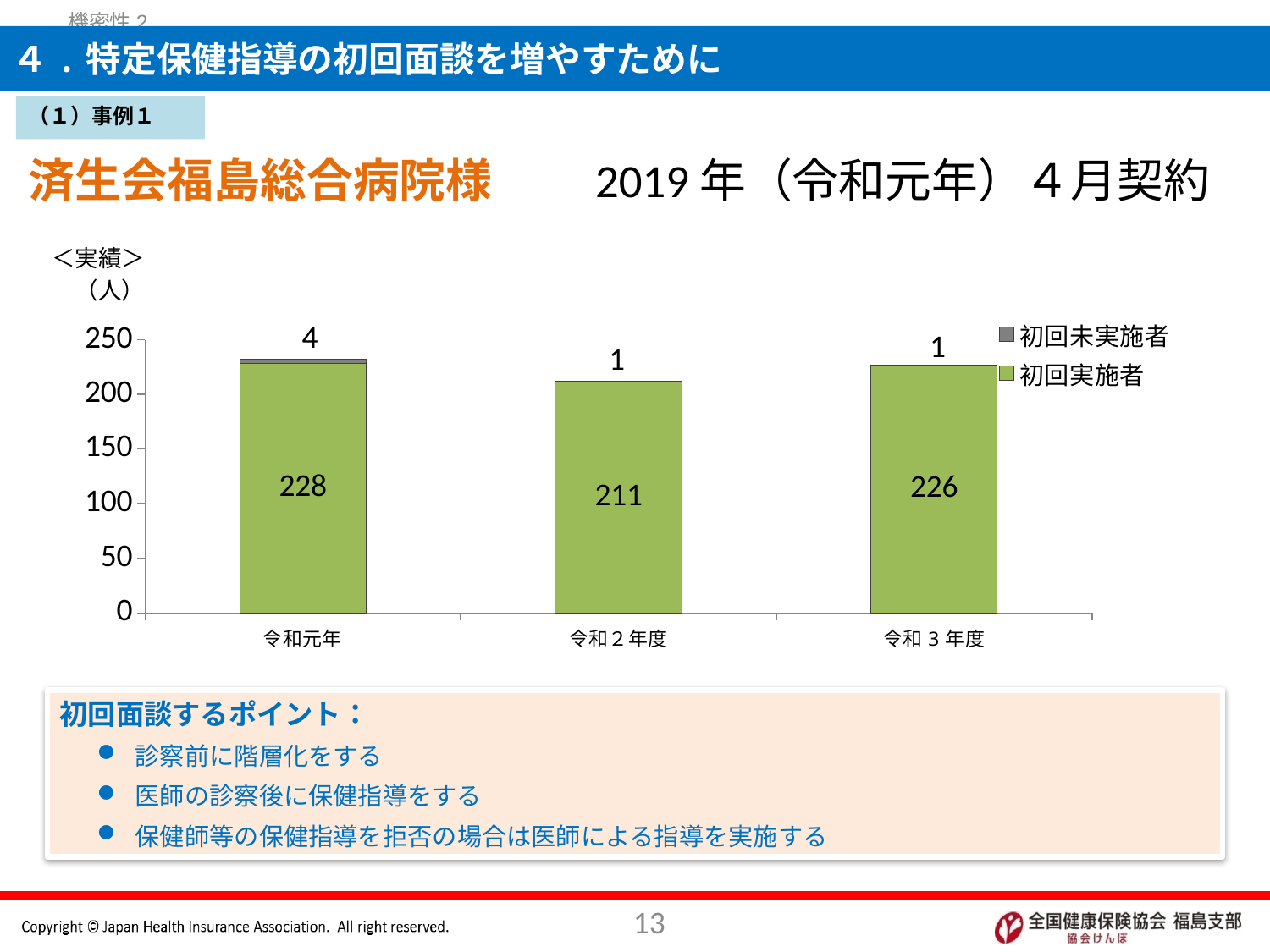
Which year has the lowest value of 初回実施者? 令和２年度 What is the difference in 初回実施者 between 令和元年 and 令和２年度? 17 What is the value of 初回実施者 for 令和元年? 228 How many series does the legend list? 2 What is the total of the stacked bar for 令和元年? 232 What is the value of 初回未実施者 for 令和元年? 4 Which is larger, the 初回実施者 value for 令和３年度 or for 令和２年度? 令和３年度 Which year has the highest value of 初回実施者? 令和元年 What kind of chart is shown on the slide? Stacked bar chart What is the value of 初回未実施者 for 令和３年度? 1 What is the value of 初回実施者 for 令和２年度? 211 How many years are shown on the x axis? 3